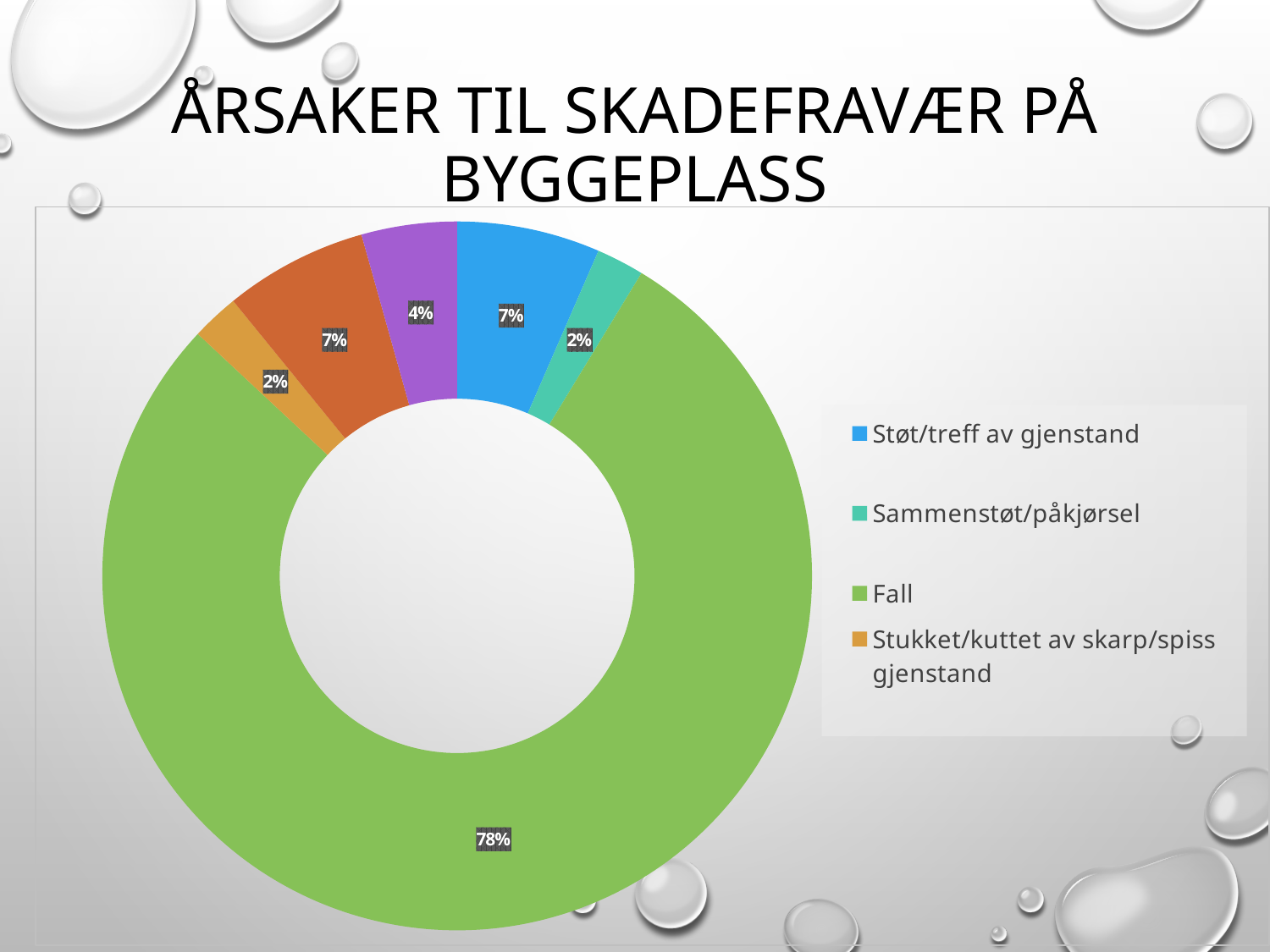
What kind of chart is shown on the slide? Doughnut (pie) chart What colour is the slice for Fall? Green What percentage of the chart does Fall account for? 78% How many slices does the chart have? 6 Which is larger, the slice for Fall or the slice for Støt/treff av gjenstand? Fall What is the title of the chart on the slide? ÅRSAKER TIL SKADEFRAVÆR PÅ BYGGEPLASS How many entries are listed in the chart's legend? 4 What is the value shown for Stukket/kuttet av skarp/spiss gjenstand? 2% Which category has the largest slice in the chart? Fall What is the value shown for Sammenstøt/påkjørsel? 2% What is the difference between the value for Fall and the value for Støt/treff av gjenstand? 71% What is the value shown for Støt/treff av gjenstand? 7%